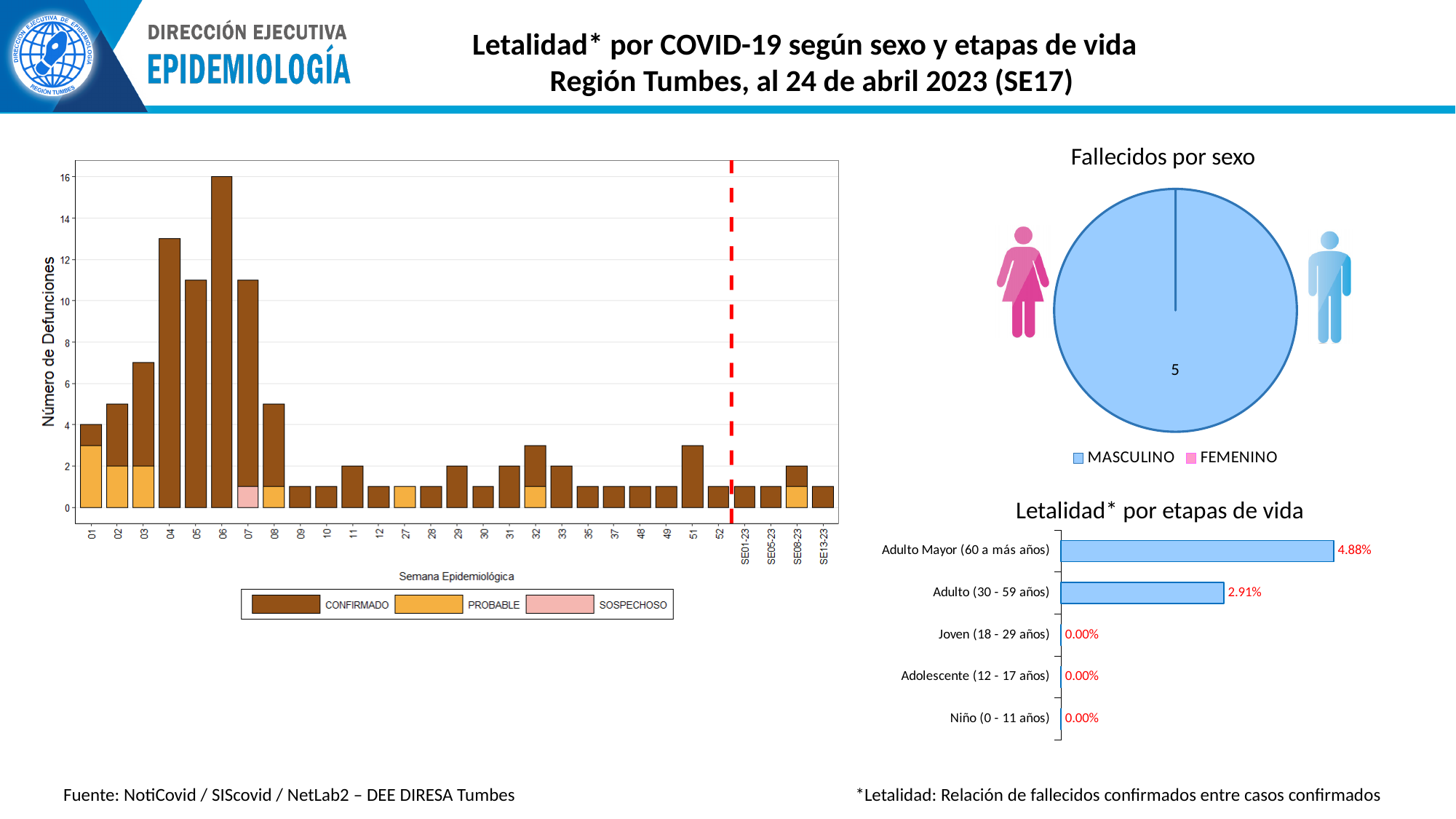
In the 'Letalidad* por etapas de vida' chart, how many age groups are shown? 5 In the 'Fallecidos por sexo' pie chart, how many categories does the legend list? 2 In the bar chart on the left (Número de Defunciones by Semana Epidemiológica), what type of chart is it? Stacked bar chart In the 'Letalidad* por etapas de vida' chart, what is the value for Adulto (30 - 59 años)? 2.91% In the 'Letalidad* por etapas de vida' chart, what is the difference between the values for Adulto Mayor (60 a más años) and Adulto (30 - 59 años)? 1.97% In the bar chart on the left (Número de Defunciones by Semana Epidemiológica), which week has the highest number of deaths? 06 In the 'Fallecidos por sexo' pie chart, what value is printed on the MASCULINO slice? 5 In the 'Letalidad* por etapas de vida' chart, which age group has the highest lethality? Adulto Mayor (60 a más años) In the 'Letalidad* por etapas de vida' chart, what is the value for Adulto Mayor (60 a más años)? 4.88% In the bar chart on the left (Número de Defunciones by Semana Epidemiológica), is the value for week 04 greater or less than 12? greater In the 'Letalidad* por etapas de vida' chart, what is the value for Joven (18 - 29 años)? 0.00% In the bar chart on the left (Número de Defunciones by Semana Epidemiológica), how many series does the legend list? 3